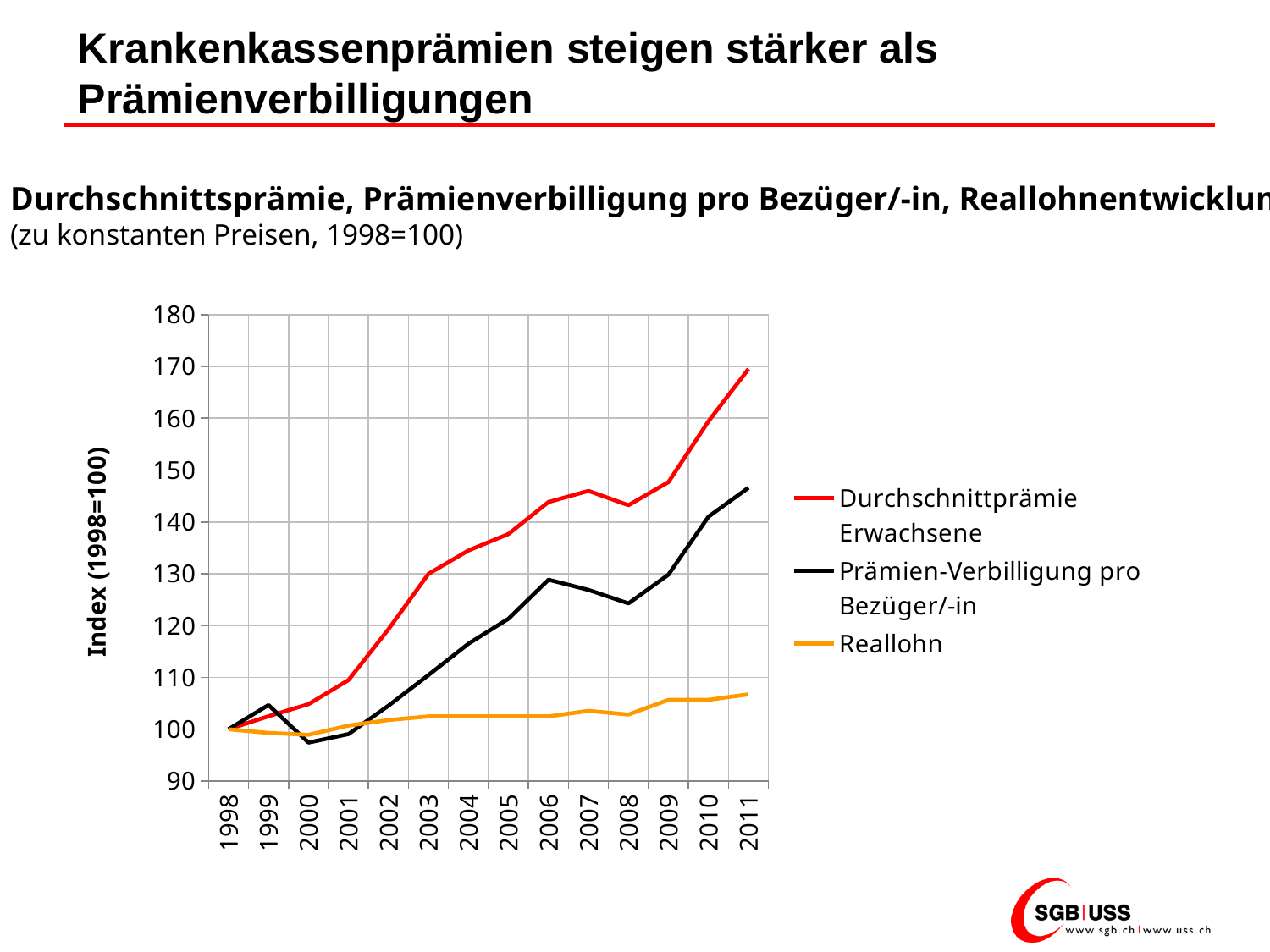
Is the value for Durchschnittprämie Erwachsene in 2011 greater or less than 160? greater Does the Durchschnittprämie Erwachsene series generally rise or fall from 1998 to 2011? Rise What is the index value of all three series in 1998? 100 How many years are shown on the x axis? 14 Is the value for Reallohn in 2011 greater or less than 110? less Which series has the highest value in 2011? Durchschnittprämie Erwachsene How many series does the legend list? 3 What is the title of the vertical axis? Index (1998=100) In 2008, which is larger: Durchschnittprämie Erwachsene or Prämien-Verbilligung pro Bezüger/-in? Durchschnittprämie Erwachsene Which series has the lowest value in 2011? Reallohn What kind of chart is shown on the slide? Line chart Is the value for Prämien-Verbilligung pro Bezüger/-in in 2000 greater or less than 100? less